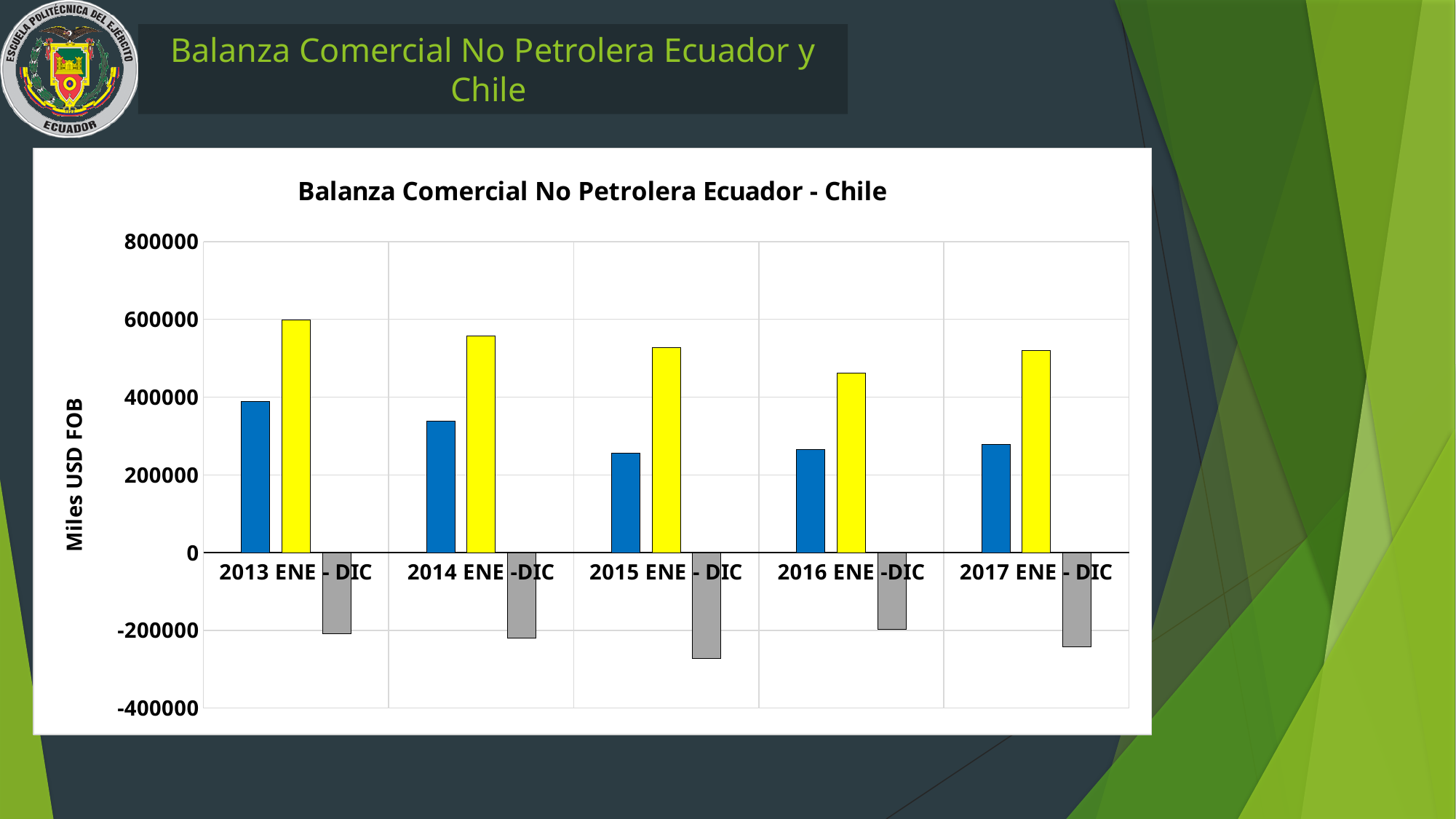
In which year category is the yellow bar the lowest? 2016 ENE -DIC Is the value of the blue bar for 2013 ENE - DIC greater or less than 200000? greater How many year categories are shown on the x axis of the chart? 5 Is the value of the gray bar for 2015 ENE - DIC greater or less than -200000? less Which is larger, the blue bar for 2013 ENE - DIC or the blue bar for 2014 ENE -DIC? 2013 ENE - DIC Is the value of the yellow bar for 2016 ENE -DIC greater or less than 600000? less What is the title of the chart? Balanza Comercial No Petrolera Ecuador - Chile In which year category is the yellow bar the highest? 2013 ENE - DIC What is the label on the vertical axis of the chart? Miles USD FOB Do the yellow bars rise or fall from 2013 ENE - DIC to 2016 ENE -DIC? fall How many bars are plotted for each year category in the chart? 3 What kind of chart is shown on the slide? bar chart